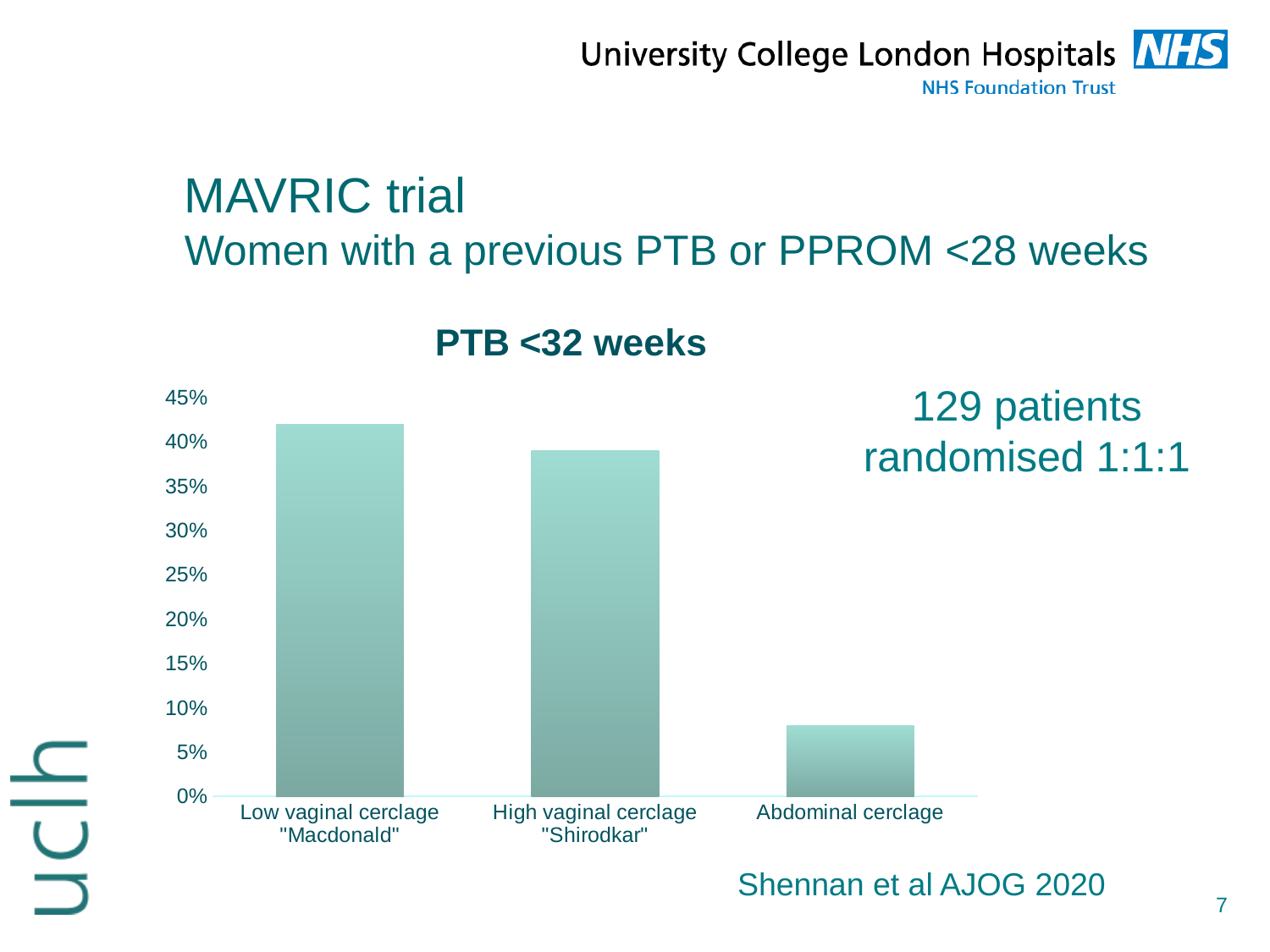
Which category has the highest value in the chart? Low vaginal cerclage "Macdonald" How many categories are plotted in the chart? 3 Is the value for High vaginal cerclage "Shirodkar" greater or less than 35%? greater What kind of chart is shown on the slide? bar chart What is the title of the chart? PTB <32 weeks What is the highest value shown on the vertical axis of the chart? 45% Which is larger, the value for High vaginal cerclage "Shirodkar" or the value for Abdominal cerclage? High vaginal cerclage "Shirodkar" Which is larger, the value for Low vaginal cerclage "Macdonald" or the value for Abdominal cerclage? Low vaginal cerclage "Macdonald" Is the value for Abdominal cerclage greater or less than 10%? less Is the value for Low vaginal cerclage "Macdonald" greater or less than 30%? greater Do the values rise or fall moving from left to right across the categories? fall Which category has the lowest value in the chart? Abdominal cerclage